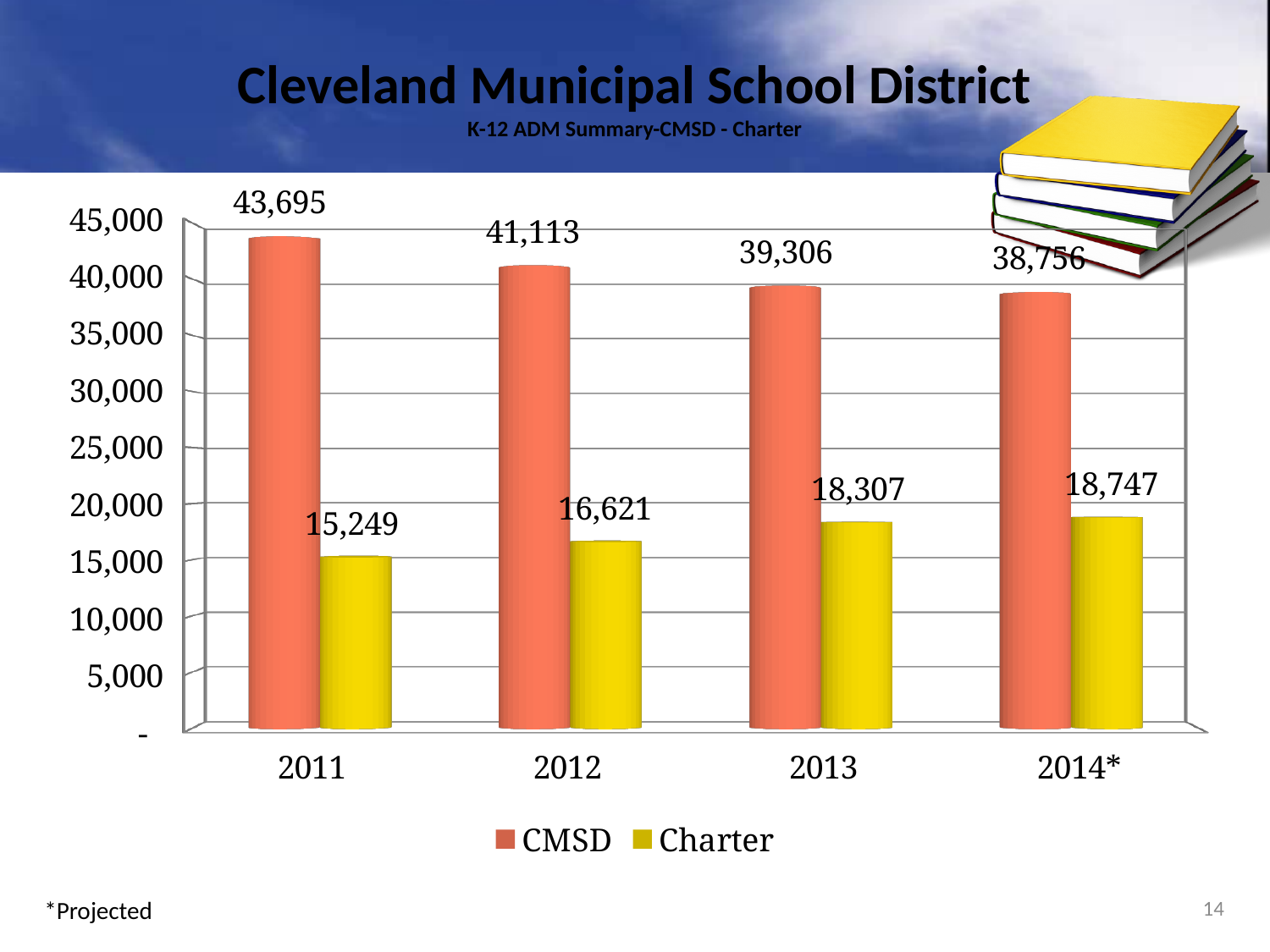
Which year has the highest CMSD value? 2011 Which year has the lowest Charter value? 2011 What is the Charter value for 2013? 18,307 Which is larger, the Charter value for 2014* or the Charter value for 2013? 2014* What is the Charter value for 2012? 16,621 Do the CMSD values rise or fall from 2011 to 2014*? fall How many series does the legend list? 2 How many years are shown on the x axis? 4 What is the CMSD value for 2011? 43,695 What is the difference between the CMSD and Charter values in 2012? 24,492 What is the CMSD value for 2014*? 38,756 What kind of chart is shown? bar chart